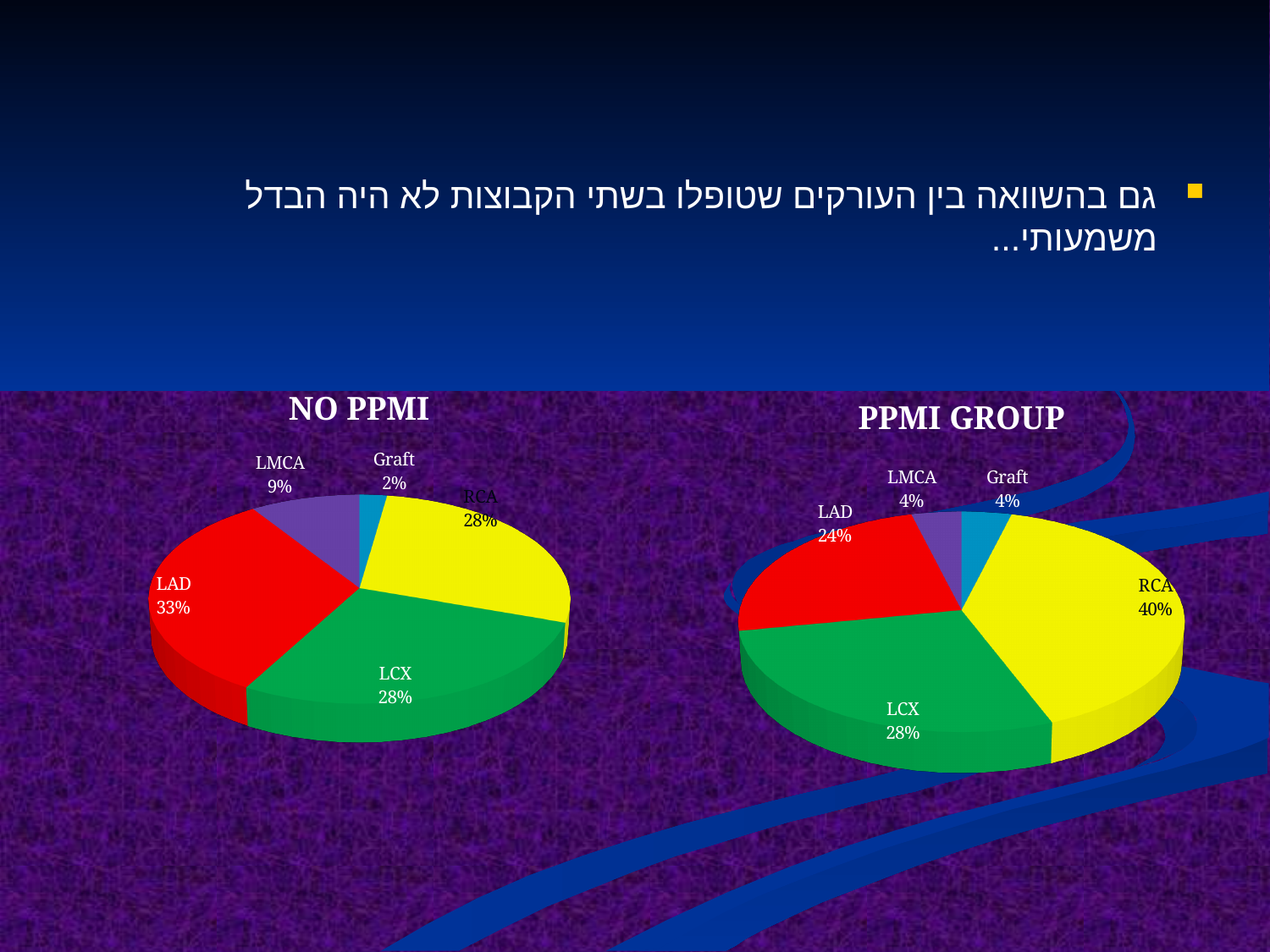
In the NO PPMI chart, what percentage is shown for LAD? 33% How many categories are shown in the PPMI GROUP chart? 5 In the NO PPMI chart, what percentage is shown for Graft? 2% What type of chart is the NO PPMI chart? Pie chart What is the difference between the RCA share in the PPMI GROUP chart and the RCA share in the NO PPMI chart? 12% In the PPMI GROUP chart, what percentage is shown for LMCA? 4% In the NO PPMI chart, which category has the smallest share? Graft In the PPMI GROUP chart, what percentage is shown for RCA? 40% In the PPMI GROUP chart, what colour is the LCX slice? Green In the PPMI GROUP chart, which category has the largest share? RCA Which is larger: the LAD share in the NO PPMI chart or the LAD share in the PPMI GROUP chart? NO PPMI In the NO PPMI chart, which category has the largest share? LAD